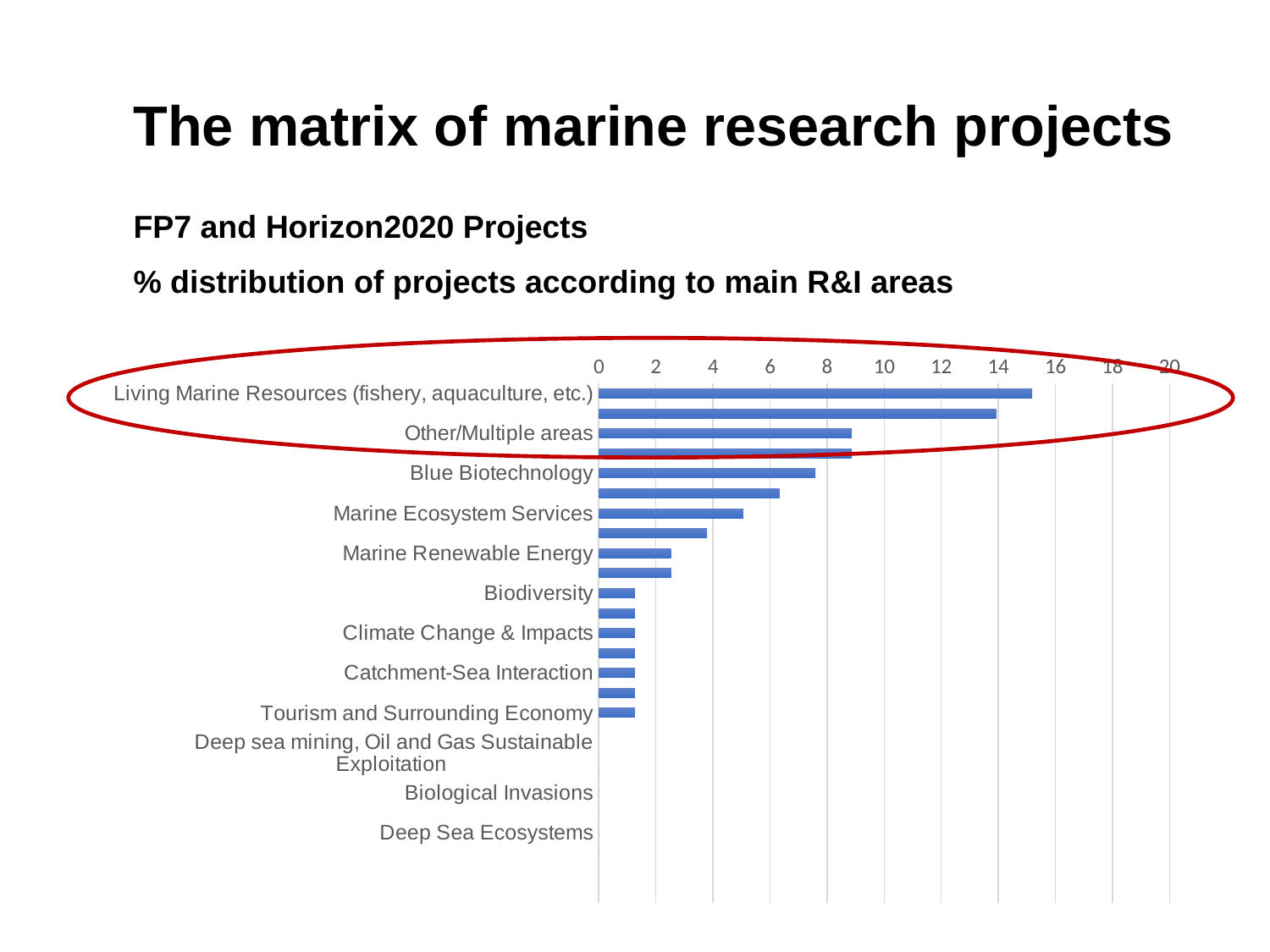
Is the value for Living Marine Resources (fishery, aquaculture, etc.) greater or less than 14? greater Do the bar values increase or decrease going from the top of the chart to the bottom? decrease Is the value for Marine Ecosystem Services greater or less than 6? less Which labelled R&I area has the highest share of projects? Living Marine Resources (fishery, aquaculture, etc.) Is the value for Biodiversity greater or less than 2? less What kind of chart is shown on the slide? bar chart Which is larger, the value for Blue Biotechnology or the value for Marine Ecosystem Services? Blue Biotechnology Which is larger, the value for Other/Multiple areas or the value for Marine Renewable Energy? Other/Multiple areas What is the highest tick value shown on the horizontal axis? 20